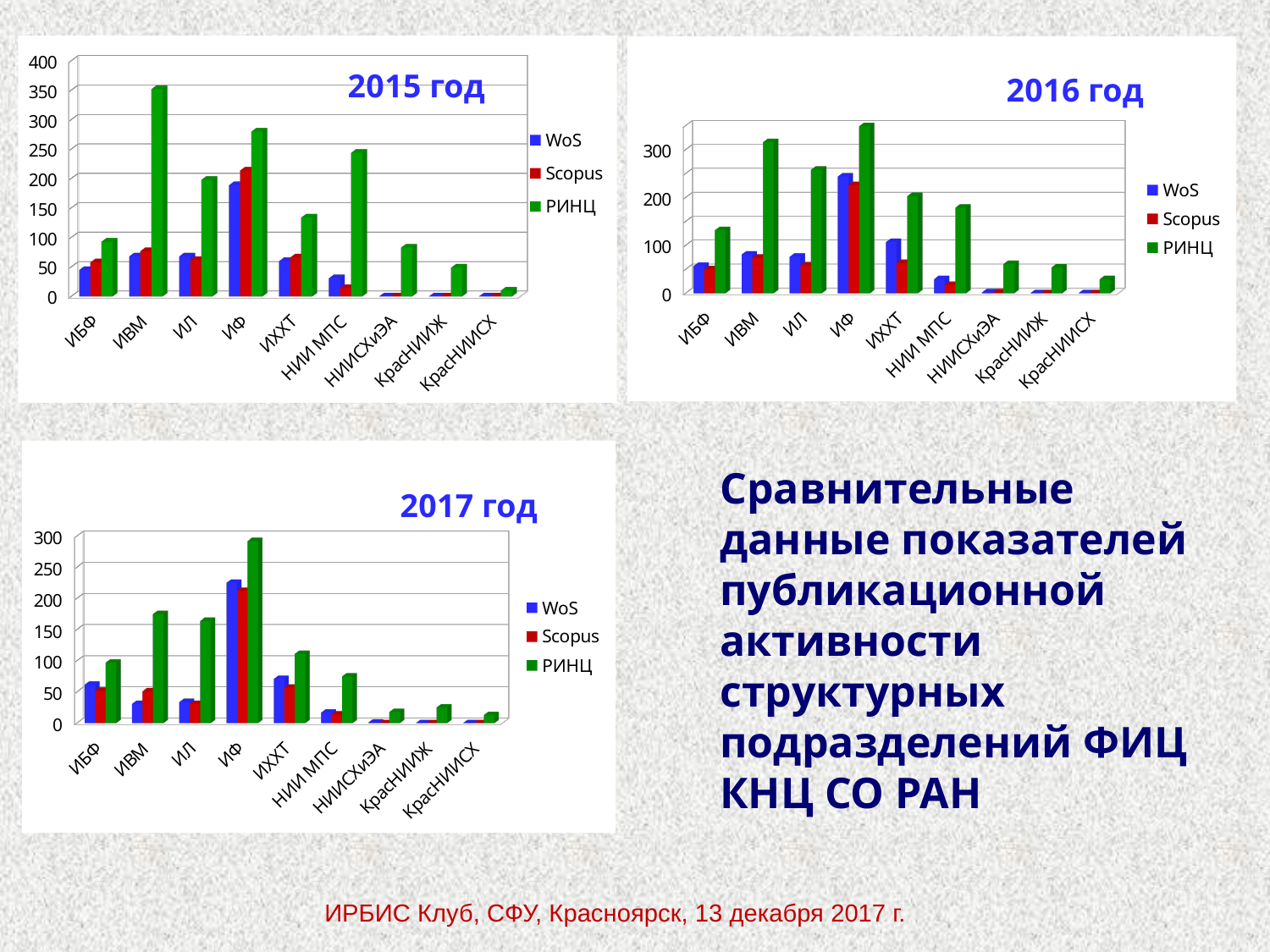
In the 2015 год chart, which category has the highest РИНЦ value? ИВМ In the 2016 год chart, which category has the highest РИНЦ value? ИФ In the 2016 год chart, which is larger for ИХХТ: the WoS value or the Scopus value? WoS In the 2015 год chart, is the РИНЦ value for ИВМ greater or less than 300? greater How many series does the legend of the 2016 год chart list? 3 In the 2017 год chart, which is larger for ИВМ: the WoS value or the Scopus value? Scopus In the 2016 год chart, is the WoS value for ИФ greater or less than 200? greater In the 2015 год chart, which is larger: the РИНЦ value for ИВМ or the РИНЦ value for ИФ? ИВМ How many categories are shown on the x axis of the 2017 год chart? 9 In the 2015 год chart, is the РИНЦ value for НИИ МПС greater or less than 200? greater In the 2017 год chart, which category has the highest РИНЦ value? ИФ